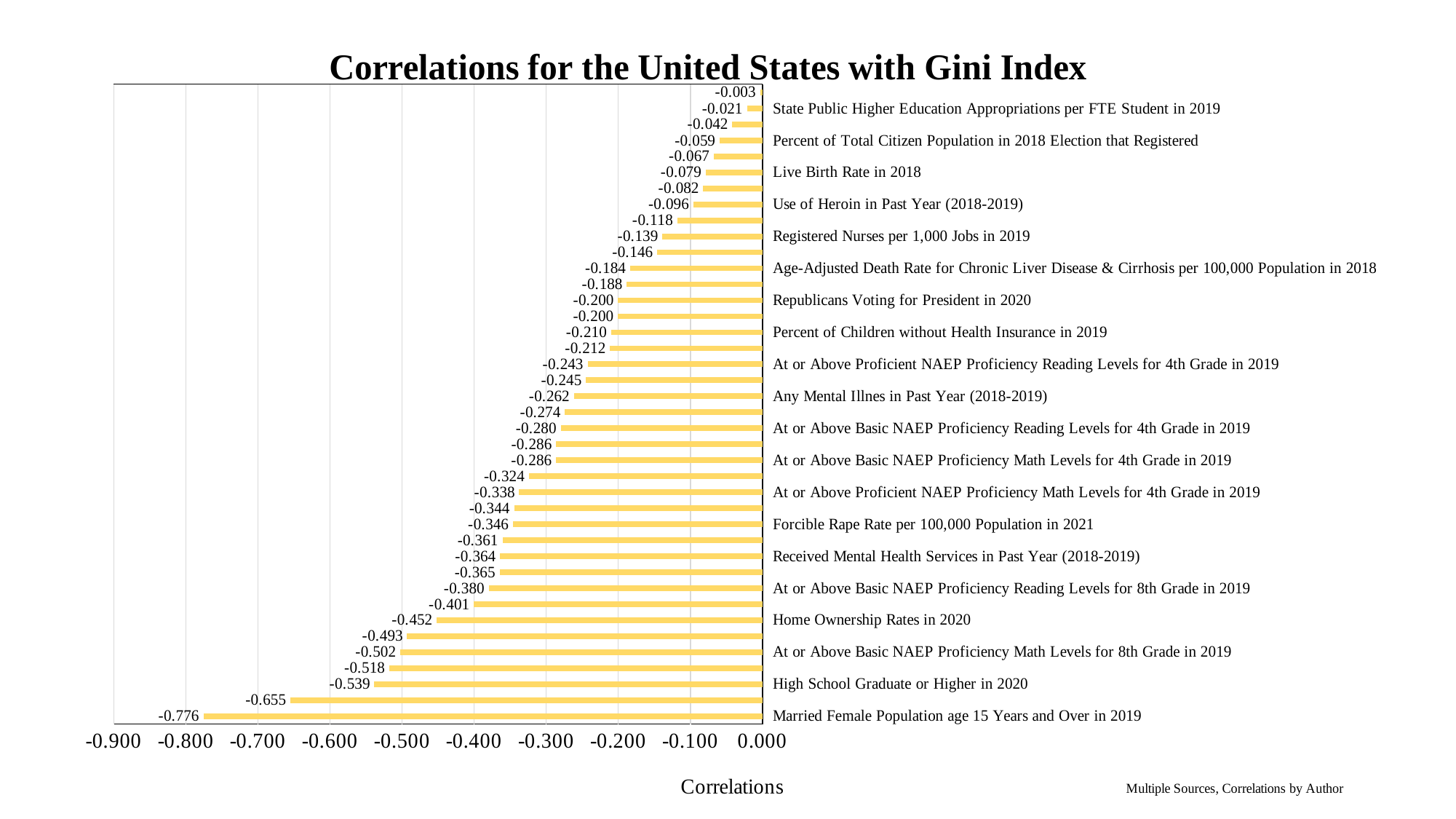
What is the correlation value for Live Birth Rate in 2018? -0.079 Which category has the lowest (most negative) correlation with the Gini Index? Married Female Population age 15 Years and Over in 2019 How many bars are plotted in the chart? 40 What is the correlation value for Married Female Population age 15 Years and Over in 2019? -0.776 What is the title of the chart? Correlations for the United States with Gini Index What is the correlation value for Home Ownership Rates in 2020? -0.452 What is the label on the horizontal axis of the chart? Correlations Is the correlation value for Forcible Rape Rate per 100,000 Population in 2021 greater or less than -0.300? less What kind of chart is shown on the slide? Bar chart What is the correlation value for High School Graduate or Higher in 2020? -0.539 Which has the larger correlation value, Use of Heroin in Past Year (2018-2019) or Registered Nurses per 1,000 Jobs in 2019? Use of Heroin in Past Year (2018-2019) What is the difference between the correlation values for Home Ownership Rates in 2020 and High School Graduate or Higher in 2020? 0.087